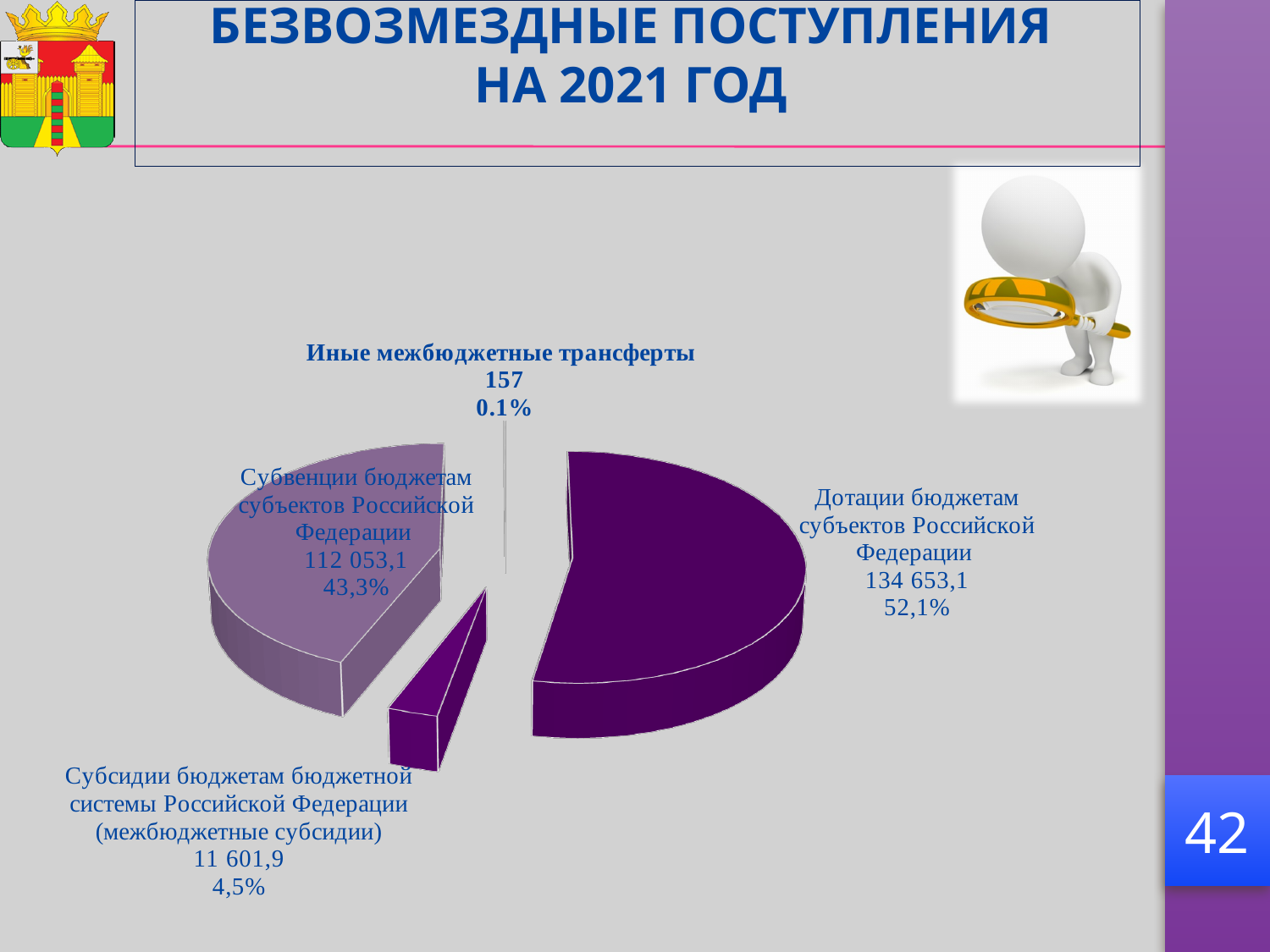
What share of the pie does Дотации бюджетам субъектов Российской Федерации have? 52,1% What share of the pie does Субвенции бюджетам субъектов Российской Федерации have? 43,3% What is the title of the slide containing the pie chart? БЕЗВОЗМЕЗДНЫЕ ПОСТУПЛЕНИЯ НА 2021 ГОД What kind of chart is shown on the slide? pie chart What is the value for Иные межбюджетные трансферты? 157 What is the value for Дотации бюджетам субъектов Российской Федерации? 134 653,1 What is the difference between the values for Дотации бюджетам субъектов Российской Федерации and Субвенции бюджетам субъектов Российской Федерации? 22 600,0 How many slices does the pie chart have? 4 Which category has the smallest slice of the pie? Иные межбюджетные трансферты What is the value for Субсидии бюджетам бюджетной системы Российской Федерации (межбюджетные субсидии)? 11 601,9 Which is larger: the value for Субсидии бюджетам бюджетной системы Российской Федерации or the value for Иные межбюджетные трансферты? Субсидии бюджетам бюджетной системы Российской Федерации Which category has the largest slice of the pie? Дотации бюджетам субъектов Российской Федерации